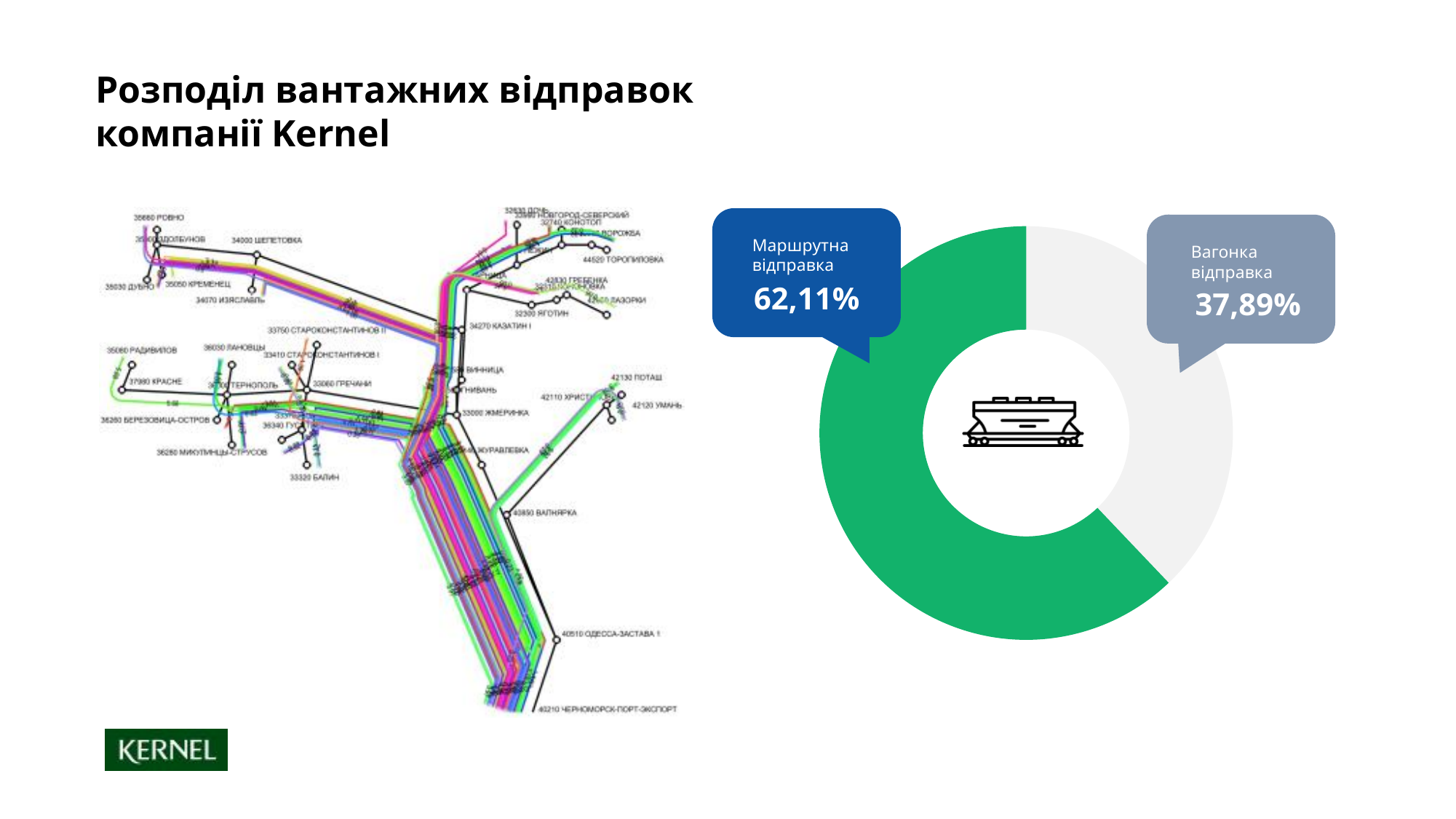
Is the share for "Вагонка відправка" greater or less than 50%? less Which category has the larger share in the donut chart? Маршрутна відправка How many categories does the donut chart show? 2 Which category has the smaller share in the donut chart? Вагонка відправка What colour is the slice for "Маршрутна відправка" in the donut chart? Green By how many percentage points does "Маршрутна відправка" exceed "Вагонка відправка" in the donut chart? 24,22 What is the combined share of the two slices in the donut chart? 100% What is the title of the slide containing the donut chart? Розподіл вантажних відправок компанії Kernel What type of chart is shown on the right side of the slide? Donut (pie) chart What share of shipments is labelled "Маршрутна відправка" in the donut chart? 62,11% What share of shipments is labelled "Вагонка відправка" in the donut chart? 37,89% Is the share for "Маршрутна відправка" larger or smaller than the share for "Вагонка відправка"? larger